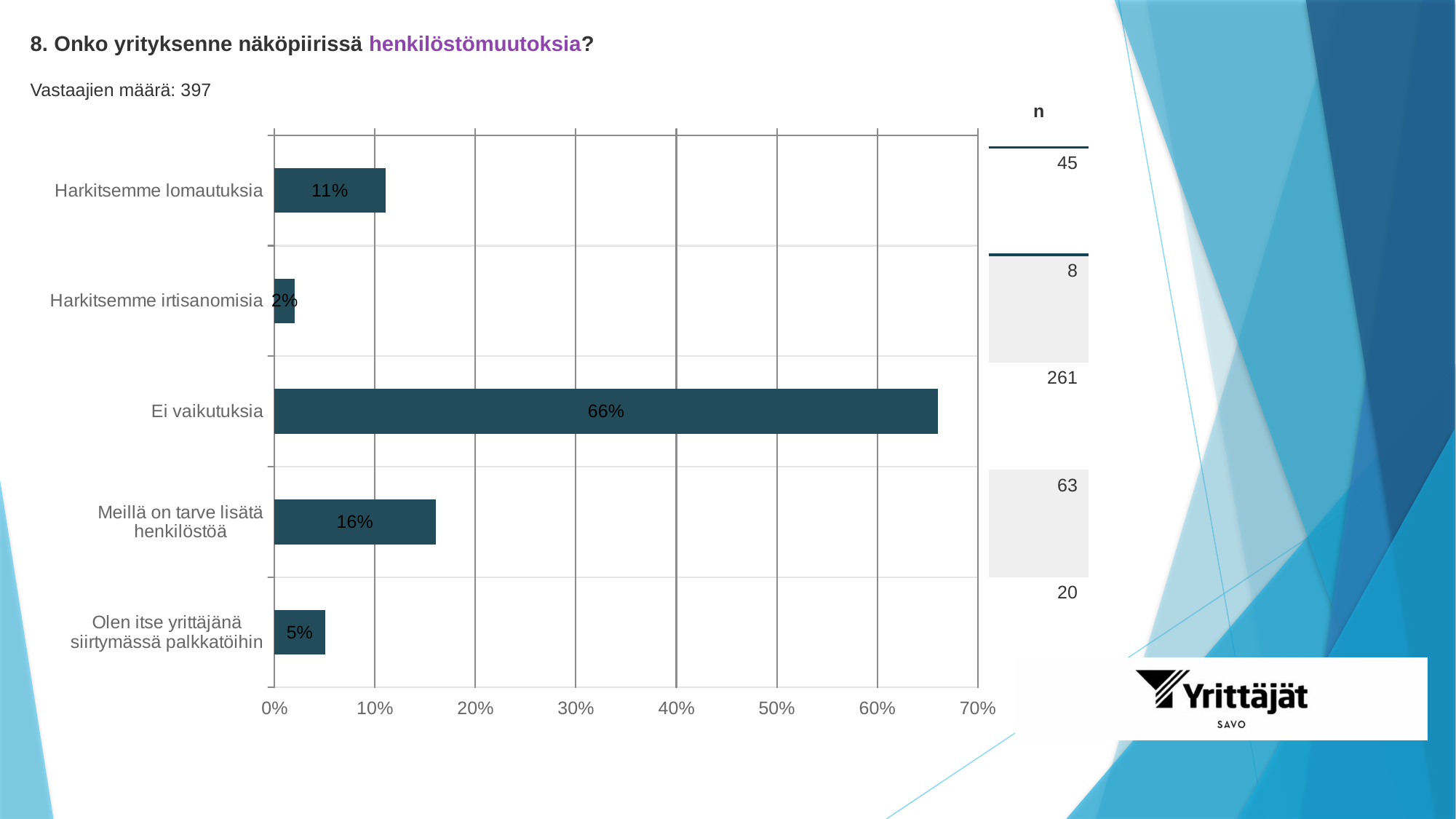
What percentage is shown for "Olen itse yrittäjänä siirtymässä palkkatöihin"? 5% Which is larger, the percentage for "Harkitsemme lomautuksia" or for "Meillä on tarve lisätä henkilöstöä"? Meillä on tarve lisätä henkilöstöä Is the value for "Ei vaikutuksia" greater or less than 60%? greater Which category has the highest percentage? Ei vaikutuksia What is the difference in percentage points between "Ei vaikutuksia" and "Meillä on tarve lisätä henkilöstöä"? 50 percentage points Which category has the lowest percentage? Harkitsemme irtisanomisia What percentage is shown for "Meillä on tarve lisätä henkilöstöä"? 16% What is the number of respondents (Vastaajien määrä) stated on the slide? 397 What percentage is shown for "Harkitsemme lomautuksia"? 11% What percentage is shown for "Ei vaikutuksia"? 66% What kind of chart is shown on the slide? Bar chart How many categories are shown in the chart? 5